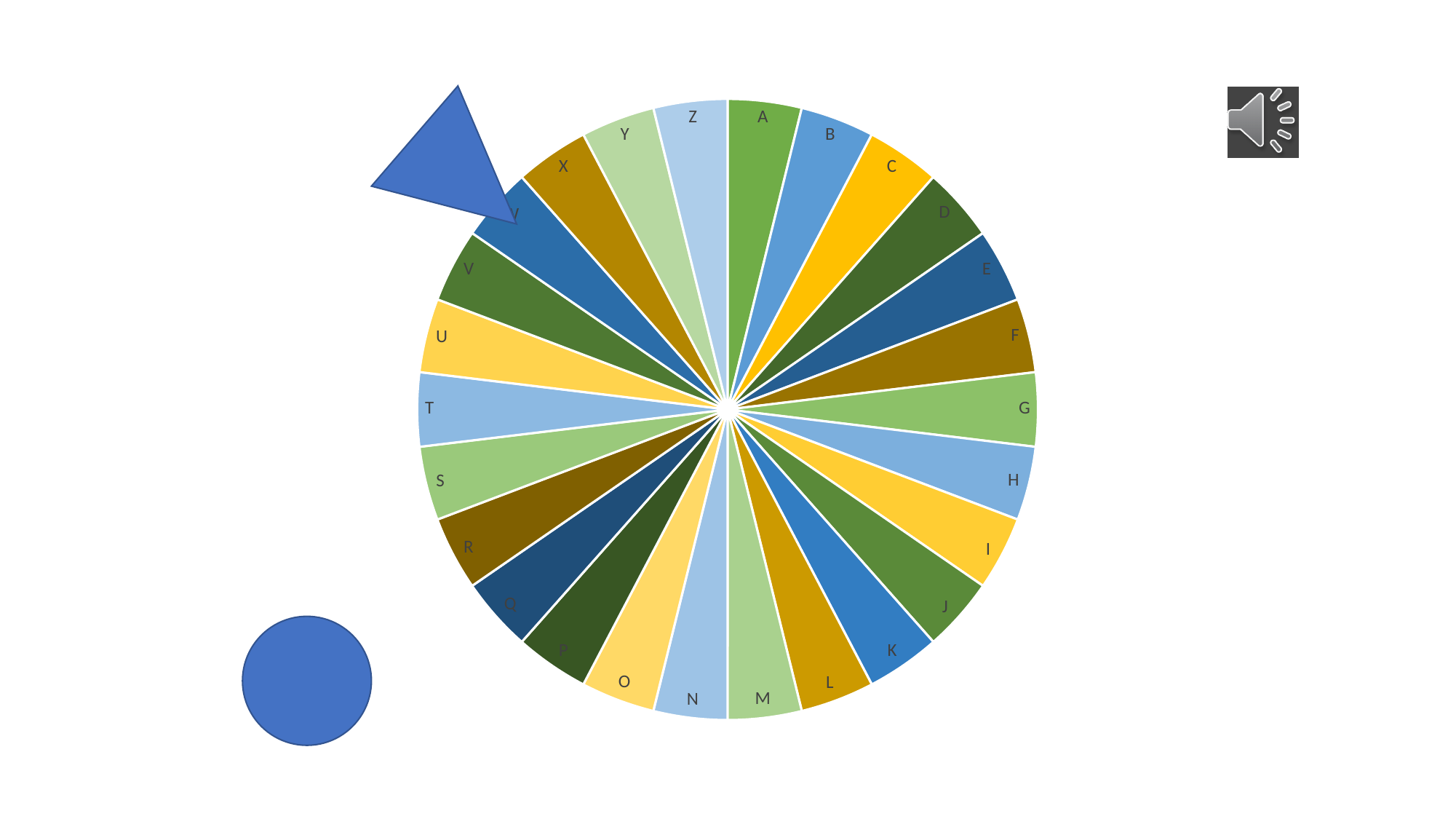
What kind of chart is shown on the slide? pie chart How many slices does the pie chart have? 26 Are the slices of the pie chart labelled with letters or numbers? letters Which slice label comes between slices F and H on the pie chart? G What is the label of the first slice clockwise from the top of the pie chart? A What is the label of the slice immediately to the left of slice A at the top of the pie chart? Z Do the slices of the pie chart appear to be equal in size or different in size? equal